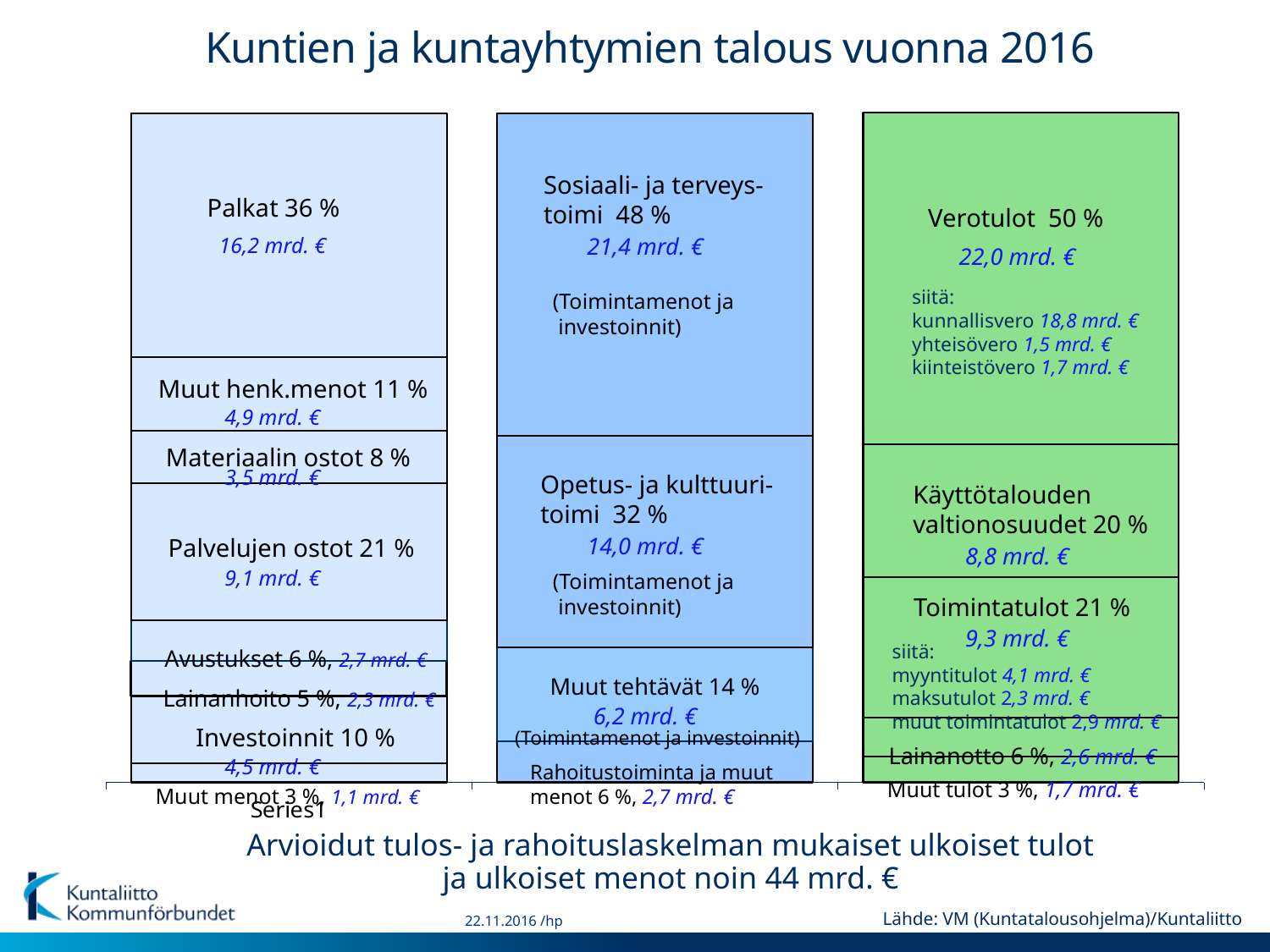
Which segment of the right bar is the largest? Verotulot What is the value in mrd. € for Käyttötalouden valtionosuudet in the right bar? 8,8 mrd. € What kind of chart is shown on the slide? stacked bar chart What is the value in mrd. € for Verotulot in the right bar? 22,0 mrd. € What is the title of the chart on the slide? Kuntien ja kuntayhtymien talous vuonna 2016 How many segments does the middle bar have? 4 What share of the left bar is Palkat? 36 % What is the difference in percentage points between Sosiaali- ja terveystoimi and Opetus- ja kulttuuritoimi in the middle bar? 16 percentage points What is the value in mrd. € for Sosiaali- ja terveystoimi in the middle bar? 21,4 mrd. € Which segment of the left bar is the smallest? Muut menot Which is larger in the left bar, Palvelujen ostot or Investoinnit? Palvelujen ostot Which segment of the middle bar is the smallest? Rahoitustoiminta ja muut menot